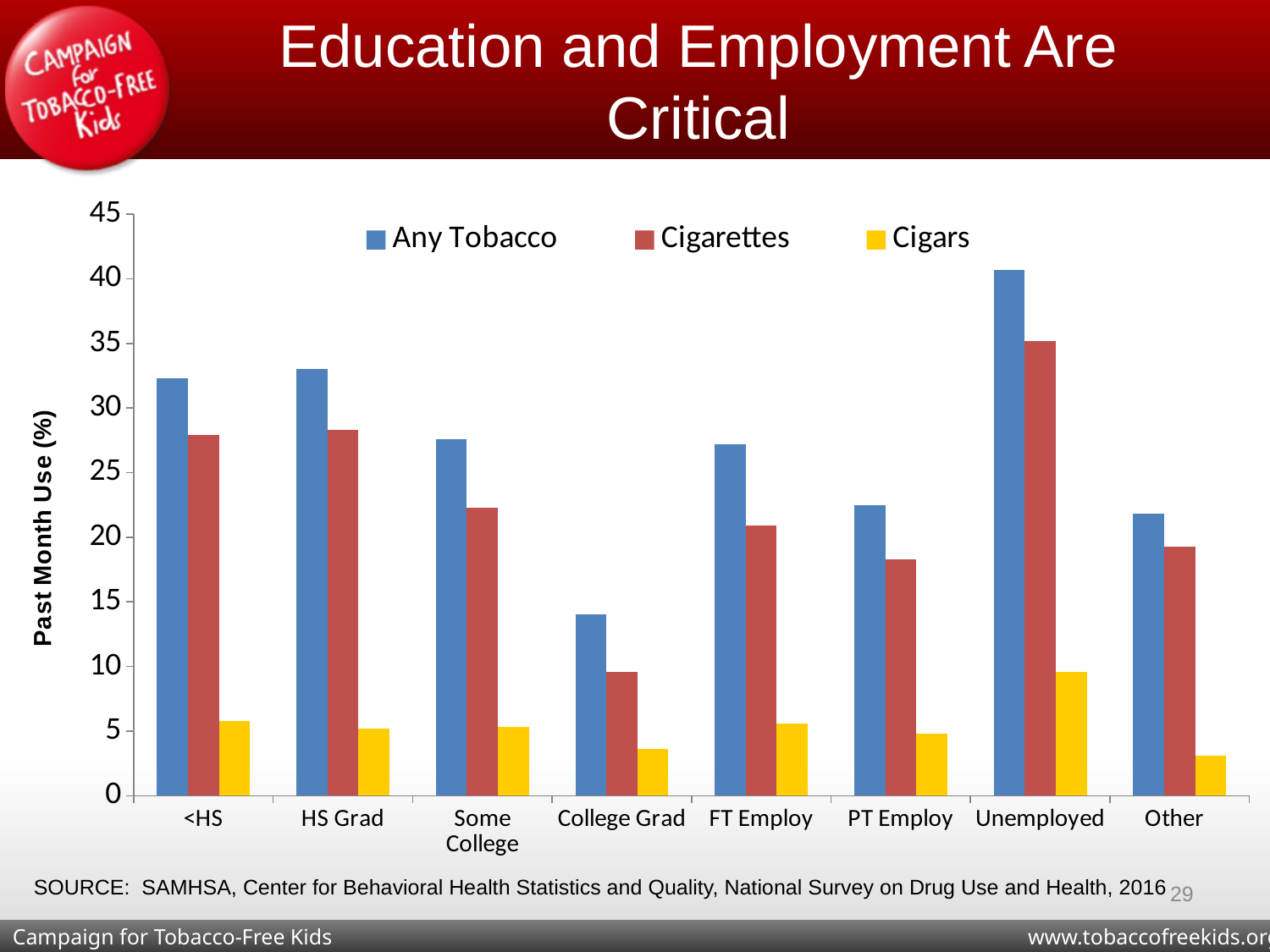
Which category has the highest Cigars value? Unemployed Which category has the lowest Any Tobacco value? College Grad How many series does the legend list? 3 Is the Cigars value for Unemployed greater or less than 5? greater Which category has the lowest Cigarettes value? College Grad Is the Any Tobacco value for Unemployed greater or less than 35? greater Which category has the highest Any Tobacco value? Unemployed What is the title of the y axis? Past Month Use (%) Is the Any Tobacco value for College Grad greater or less than 15? less What kind of chart is shown on the slide? bar chart Which is larger, the Cigarettes value for FT Employ or for PT Employ? FT Employ How many categories are shown along the x axis? 8